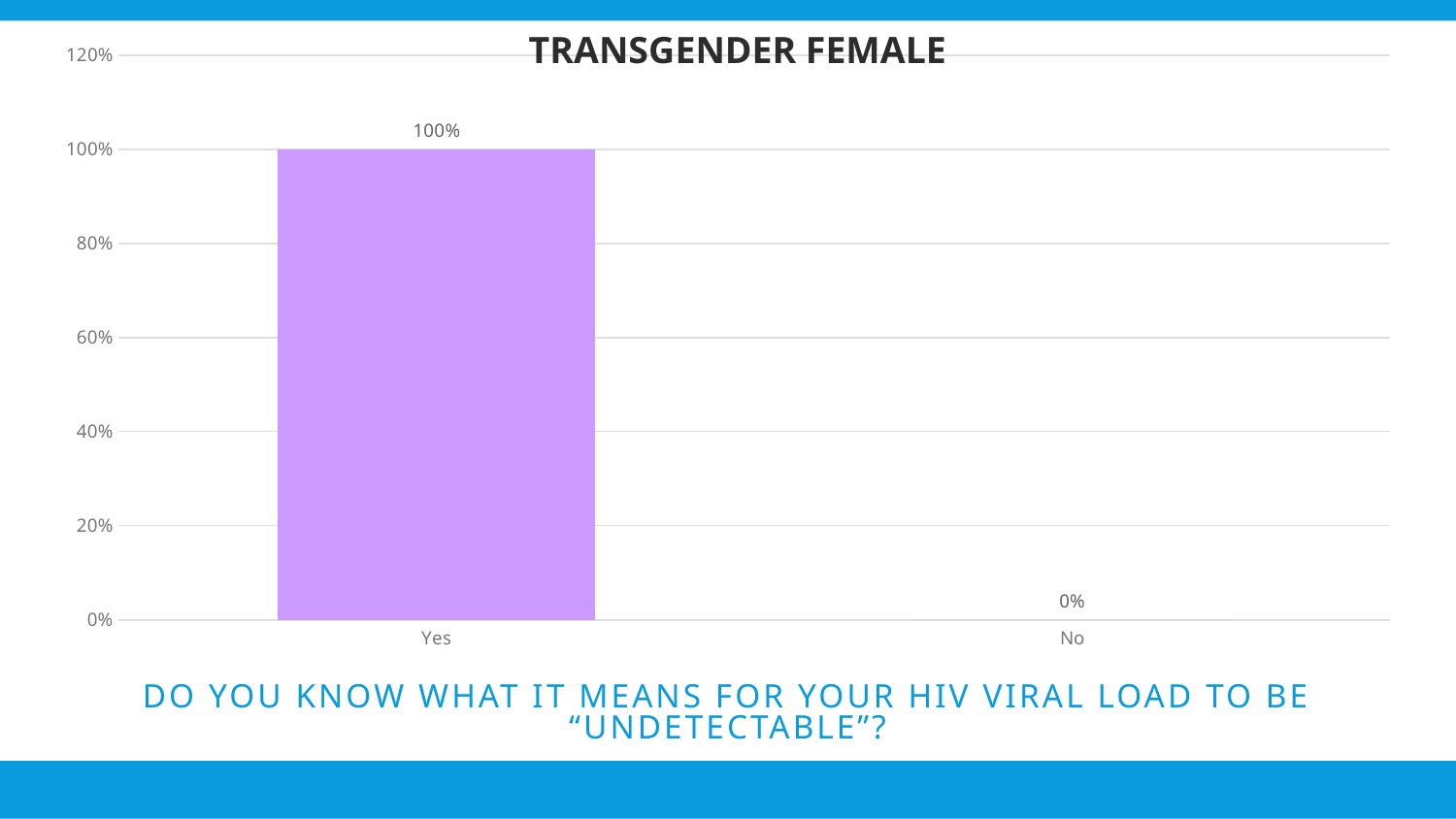
What is the title of the chart? TRANSGENDER FEMALE How many categories are shown on the x axis? 2 What is the value for No? 0% Is the value for Yes greater or less than 80%? greater What is the difference between the values for Yes and No? 100% What kind of chart is shown on the slide? bar chart Which category has the highest value? Yes What is the value for Yes? 100% Which category has the lowest value? No What is the highest value shown on the y axis? 120% Which is larger, the value for Yes or the value for No? Yes